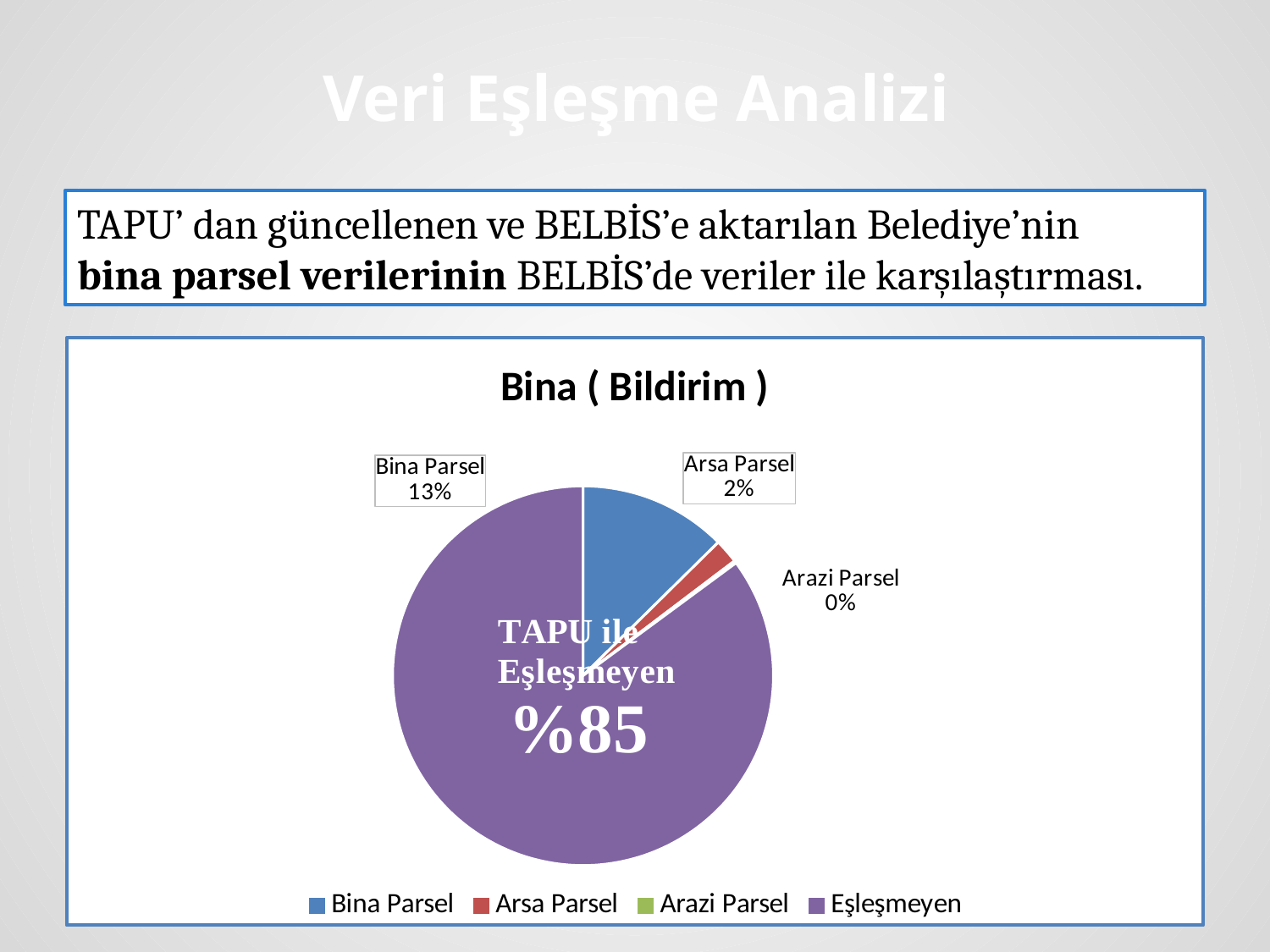
How many categories does the legend list? 4 What percentage of the pie is Arsa Parsel? 2% What kind of chart is shown on the slide? pie chart What colour is the Eşleşmeyen slice? purple Which category has the smallest slice of the pie? Arazi Parsel What percentage of the pie is Bina Parsel? 13% What share of the pie is labelled as TAPU ile Eşleşmeyen? %85 What percentage of the pie is Arazi Parsel? 0% What is the difference in percentage points between Bina Parsel and Arsa Parsel? 11% Which slice is larger, Bina Parsel or Arsa Parsel? Bina Parsel What is the title of the chart? Bina ( Bildirim ) Which category has the largest slice of the pie? Eşleşmeyen